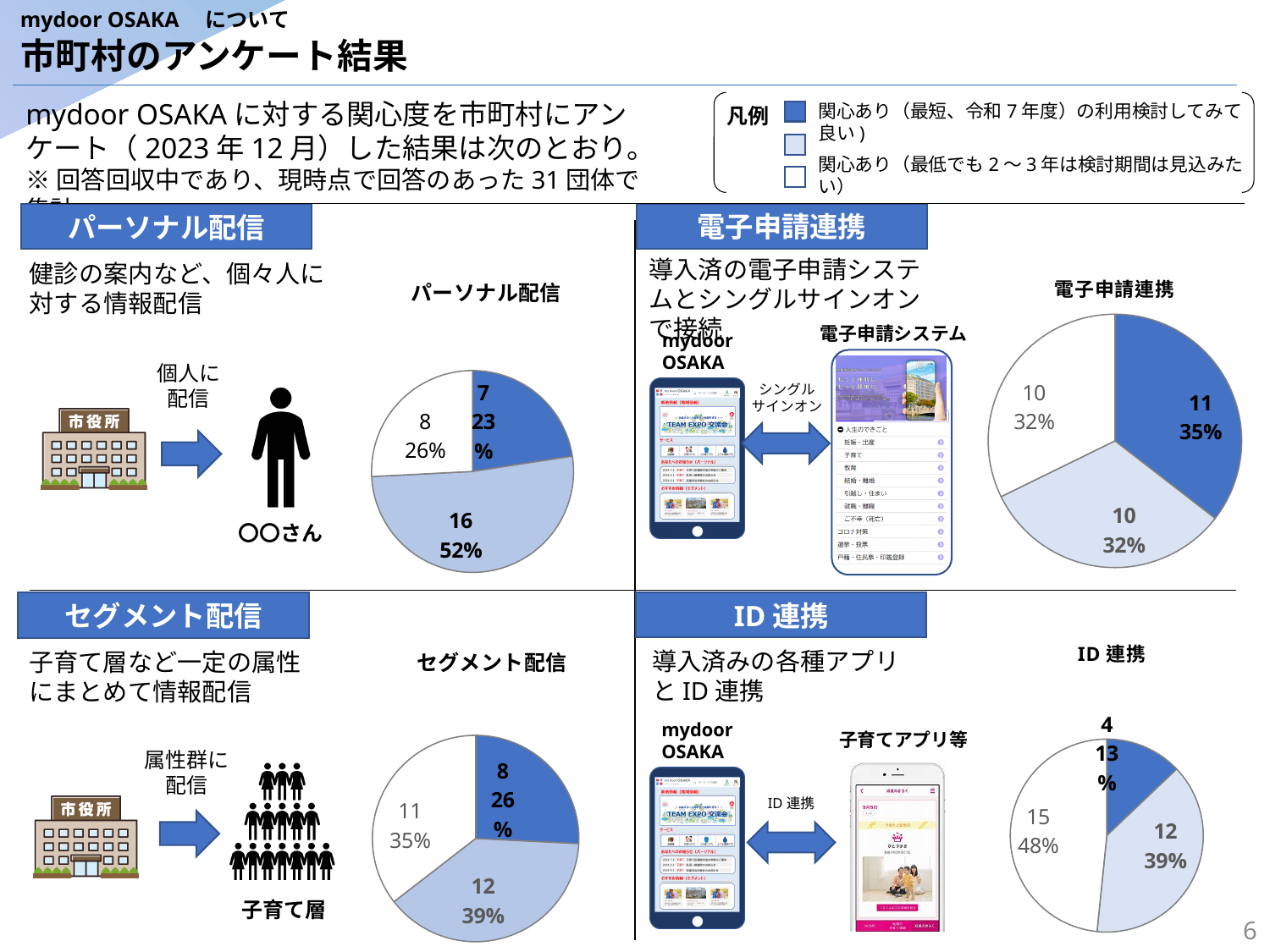
What type of chart is used for the four survey results on this slide? Pie chart In the セグメント配信 pie chart, what is the difference in respondent count between the light blue slice (12) and the dark blue slice (8)? 4 In the セグメント配信 pie chart, what percentage is shown for the light blue slice? 39% In the パーソナル配信 pie chart, which slice is the largest? 16 (52%), the light blue slice In the パーソナル配信 pie chart, what percentage is shown for the dark blue slice (関心あり（最短、令和7年度）の利用検討してみて良い)? 23% In the ID連携 pie chart, what percentage is shown for the white slice? 48% In the ID連携 pie chart, how many respondents are in the dark blue slice? 4 In the ID連携 pie chart, which slice is the smallest? 4 (13%), the dark blue slice Which chart has the larger dark blue slice: パーソナル配信 (23%) or 電子申請連携 (35%)? 電子申請連携 In the 電子申請連携 pie chart, what percentage is shown for the dark blue slice? 35% In the 電子申請連携 pie chart, how many respondents are in the light blue slice? 10 In the パーソナル配信 pie chart, how many respondents are in the light blue slice (関心あり（最低でも2～3年は検討期間は見込みたい）)? 16